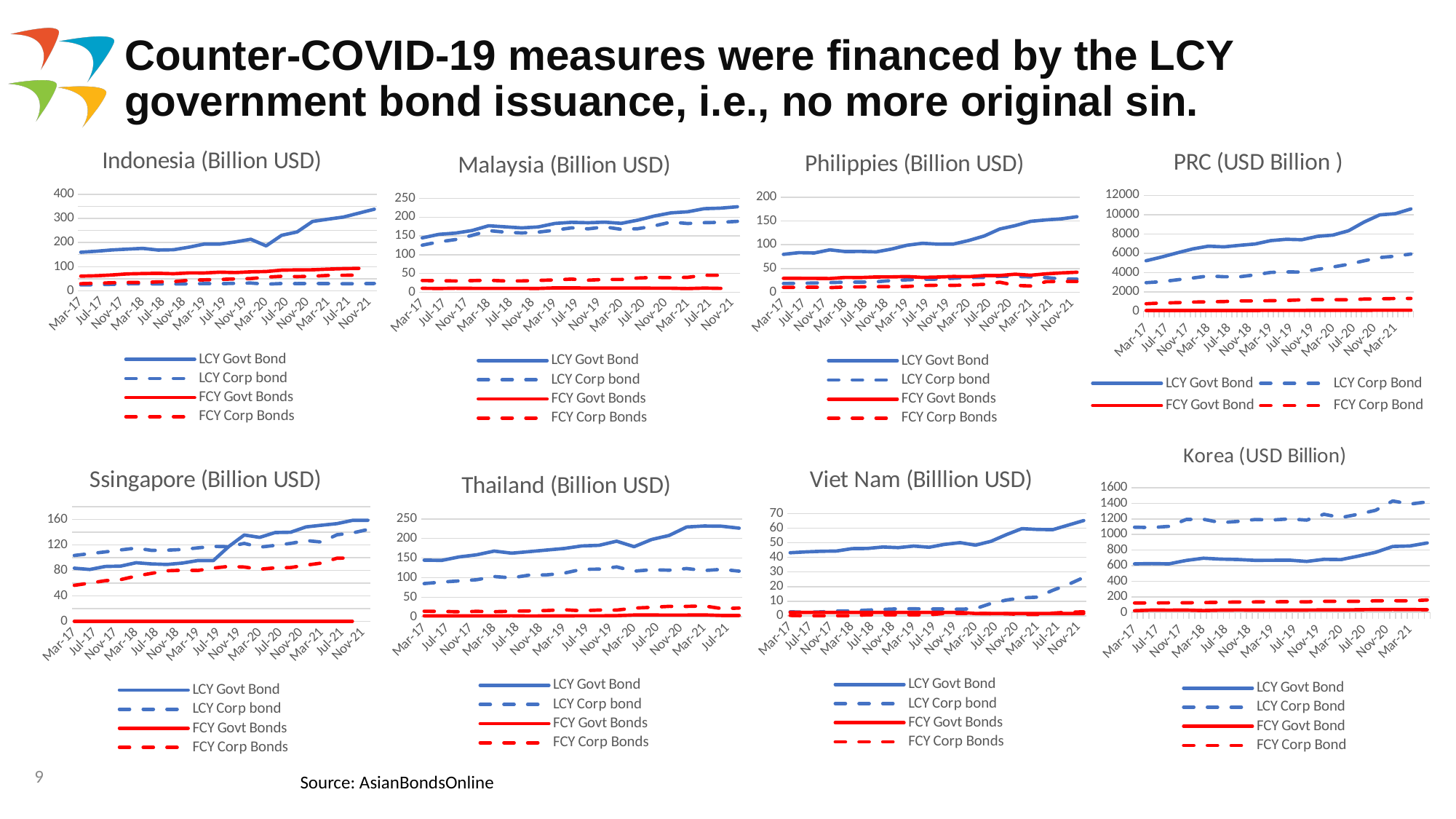
In the PRC (USD Billion) chart, does the LCY Govt Bond series rise or fall from Mar-17 to Mar-21? rise How many charts are shown on the slide? 8 In the Korea (USD Billion) chart, which is larger at Mar-21: LCY Corp Bond or LCY Govt Bond? LCY Corp Bond In the Indonesia (Billion USD) chart, is the value for LCY Govt Bond at Nov-21 greater or less than 300? greater In the Philippies (Billion USD) chart, is the value for LCY Govt Bond at Nov-21 greater or less than 100? greater In the Malaysia (Billion USD) chart, how many series does the legend list? 4 In the Viet Nam (Billlion USD) chart, is the value for LCY Govt Bond at Nov-21 greater or less than 60? greater In the Ssingapore (Billion USD) chart, which is larger at Mar-17: LCY Corp bond or LCY Govt Bond? LCY Corp bond In the Ssingapore (Billion USD) chart, does the FCY Corp Bonds series rise or fall from Mar-17 to Jul-21? rise In the Korea (USD Billion) chart, which series has the highest value at Mar-21? LCY Corp Bond What kind of chart is the Indonesia (Billion USD) chart? line chart